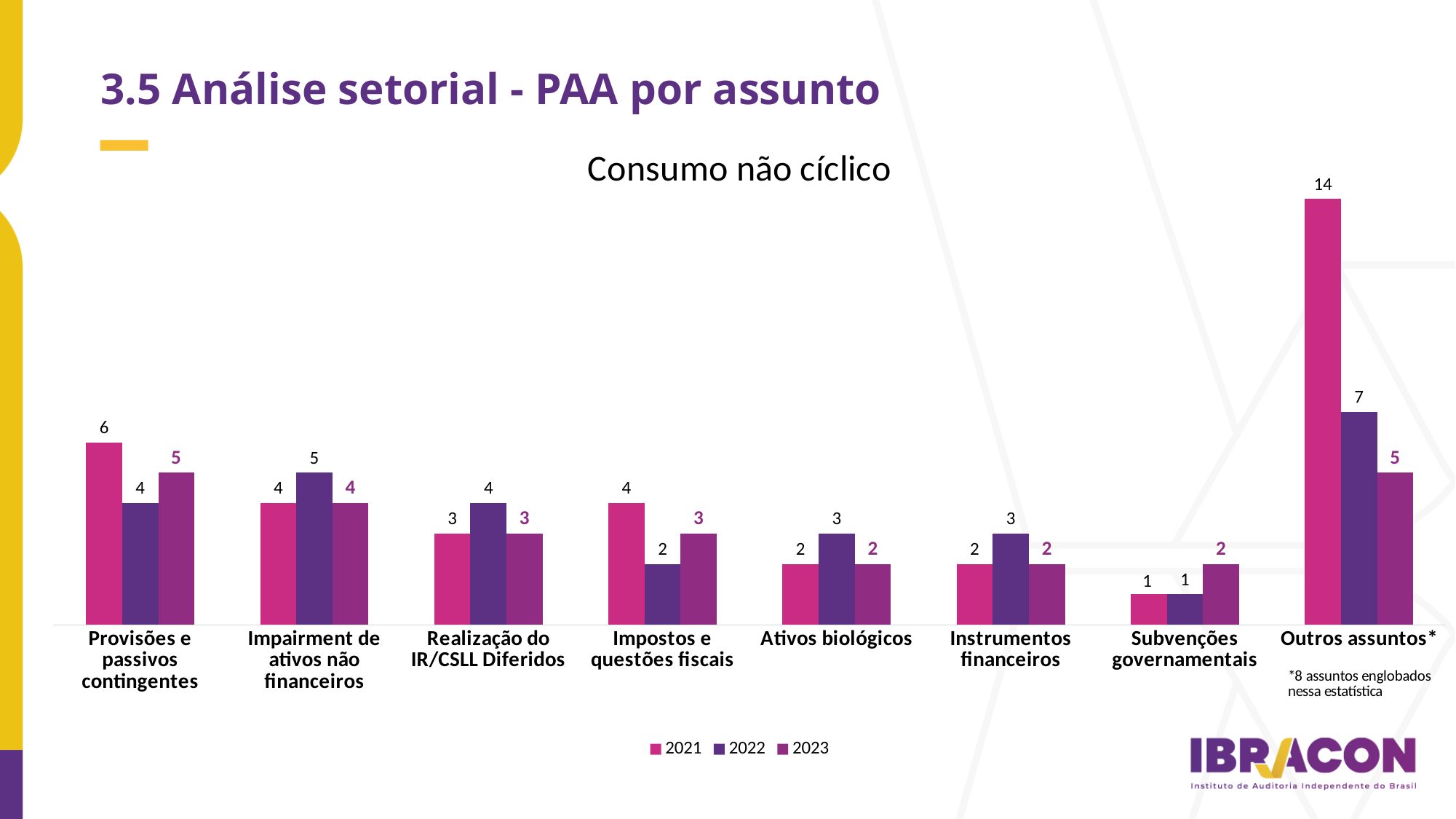
What kind of chart is shown on the slide? Bar chart What is the difference between the 2021 and 2022 values in the 'Outros assuntos*' category? 7 How many series does the legend list? 3 Which is larger in the 'Realização do IR/CSLL Diferidos' category: the 2021 value or the 2022 value? 2022 What is the value for 2023 in the 'Provisões e passivos contingentes' category? 5 What is the value for 2022 in the 'Impostos e questões fiscais' category? 2 Which category has the highest value for 2021? Outros assuntos* What is the title of the chart? Consumo não cíclico Which category has the lowest value for 2022? Subvenções governamentais What is the value for 2022 in the 'Impairment de ativos não financeiros' category? 5 How many categories are shown on the x axis? 8 What is the value for 2021 in the 'Outros assuntos*' category? 14